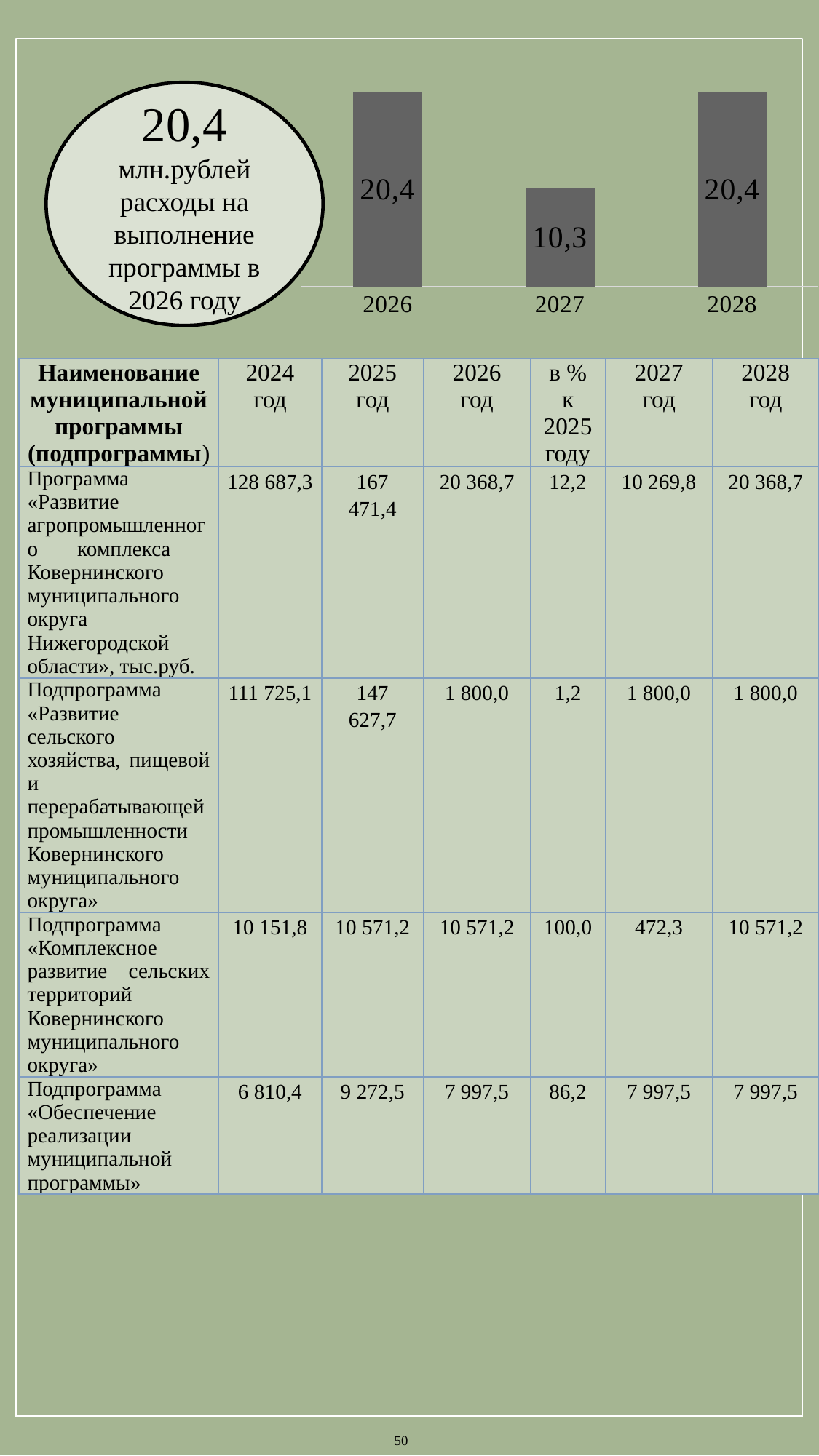
What value is shown for 2028 in the bar chart? 20,4 How does the value change from 2027 to 2028 in the bar chart? It rises What colour are the bars in the bar chart? Dark grey How many bars are plotted in the bar chart? 3 What value is shown for 2027 in the bar chart? 10,3 What value is shown for 2026 in the bar chart? 20,4 What kind of chart is shown at the top of the slide? bar chart Are the values for 2026 and 2028 in the bar chart equal? Yes How does the value change from 2026 to 2027 in the bar chart? It falls What is the difference between the values for 2026 and 2027 in the bar chart? 10,1 Which year has the lowest value in the bar chart? 2027 Which is larger in the bar chart, the value for 2027 or the value for 2028? 2028